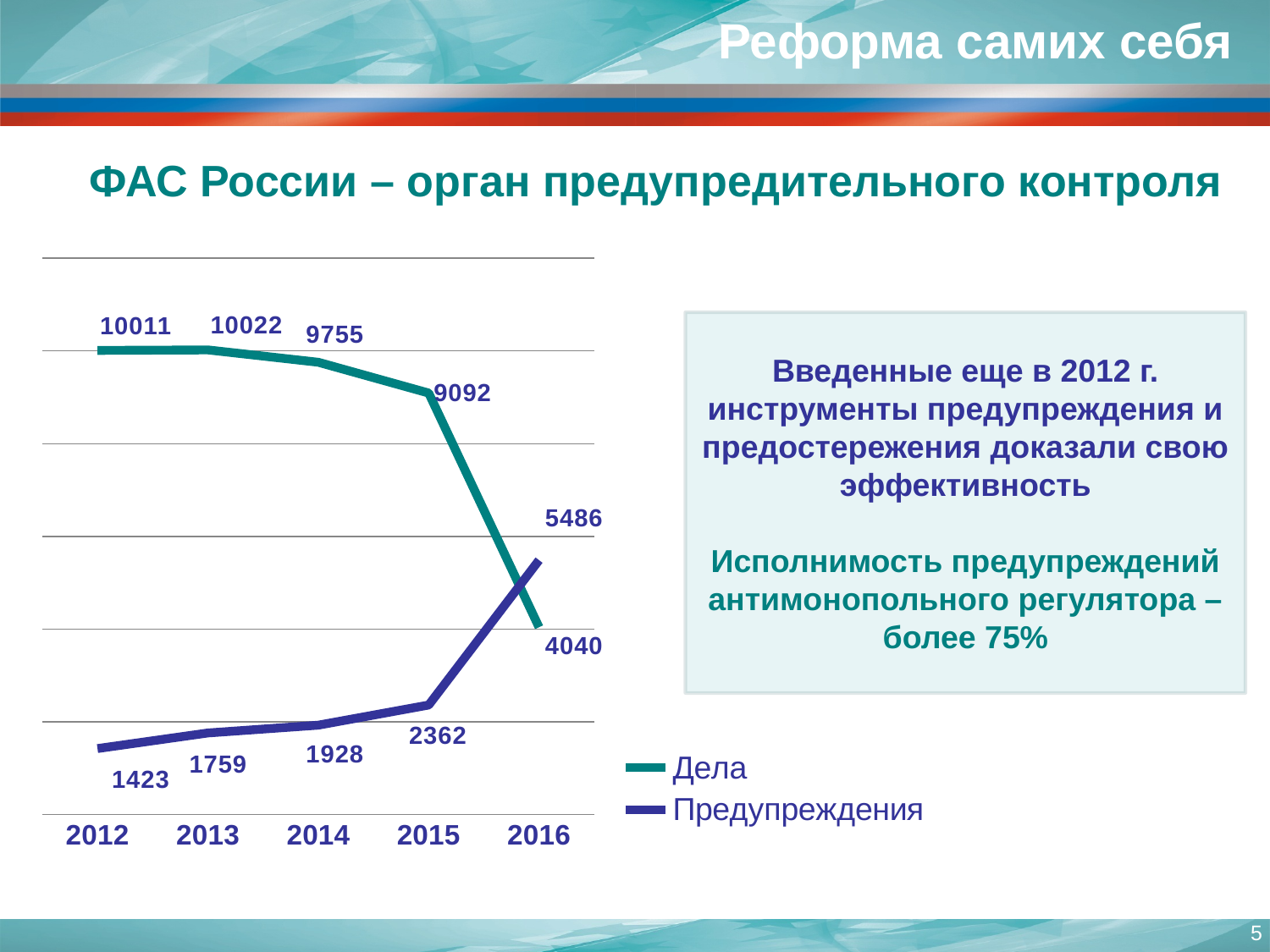
What is the value for Предупреждения in 2014? 1928 How many series does the legend list? 2 What is the value for Дела in 2012? 10011 In which year is the value for Дела highest? 2013 Which series has the larger value in 2016, Дела or Предупреждения? Предупреждения What is the value for Предупреждения in 2016? 5486 How many years are shown on the x axis? 5 What is the difference between Дела and Предупреждения in 2015? 6730 What kind of chart is shown on the slide? line chart In which year is the value for Предупреждения lowest? 2012 Does the value for Предупреждения rise or fall from 2012 to 2016? rise What is the value for Дела in 2016? 4040